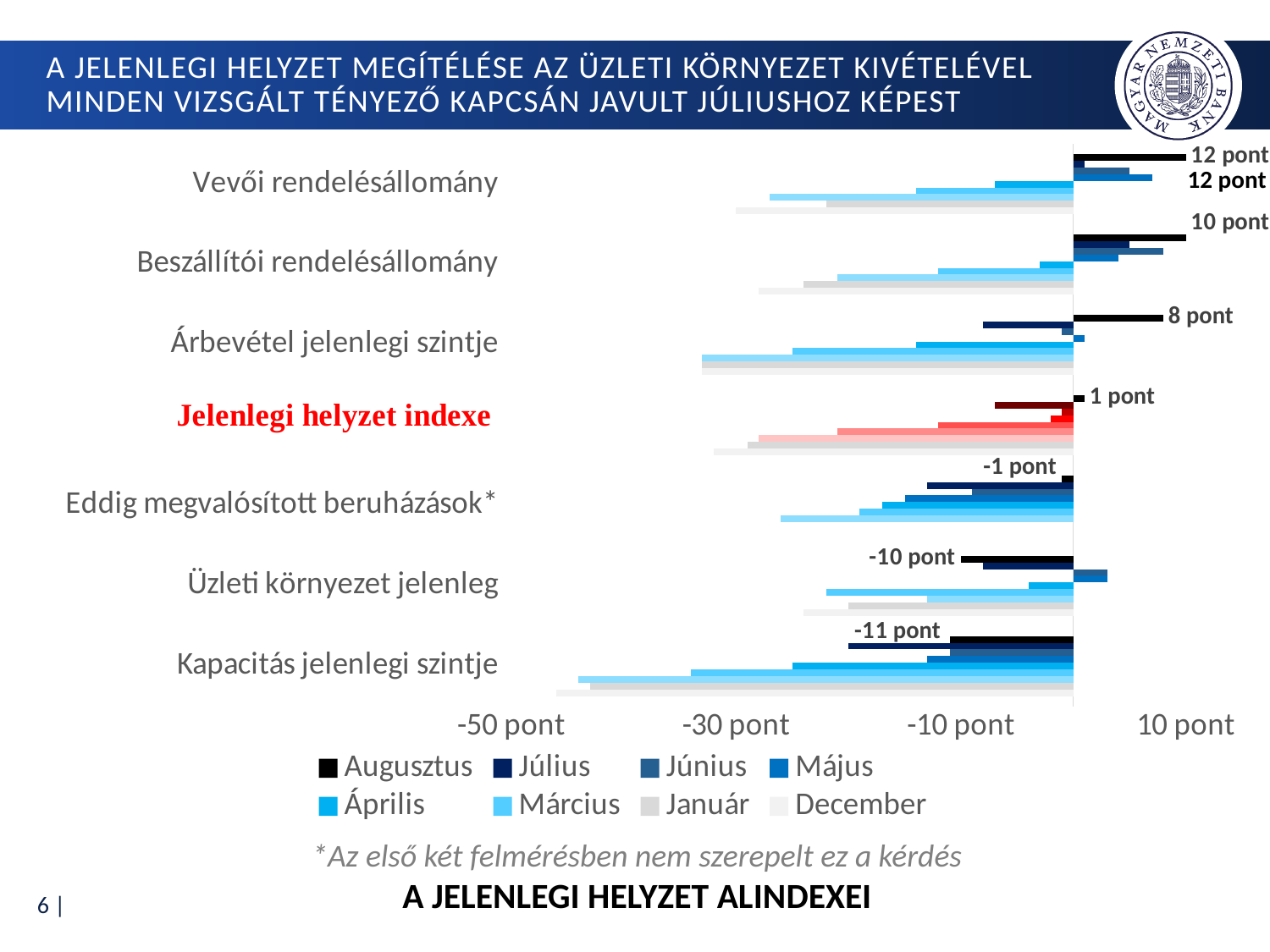
Which category has the highest Augusztus value? Vevői rendelésállomány Which is larger, the Augusztus value for Beszállítói rendelésállomány or for Eddig megvalósított beruházások? Beszállítói rendelésállomány Is the December value for Kapacitás jelenlegi szintje greater or less than -30 pont? less What is the Augusztus value for Kapacitás jelenlegi szintje? -11 pont How many series does the legend list? 8 What type of chart is shown on the slide? Bar chart What is the difference between the Augusztus values for Vevői rendelésállomány and Árbevétel jelenlegi szintje? 4 pont What is the Augusztus value for Jelenlegi helyzet indexe? 1 pont Which category has the lowest Augusztus value? Kapacitás jelenlegi szintje What is the Augusztus value for Üzleti környezet jelenleg? -10 pont What is the Augusztus value for Beszállítói rendelésállomány? 10 pont What is the Augusztus value for Vevői rendelésállomány? 12 pont